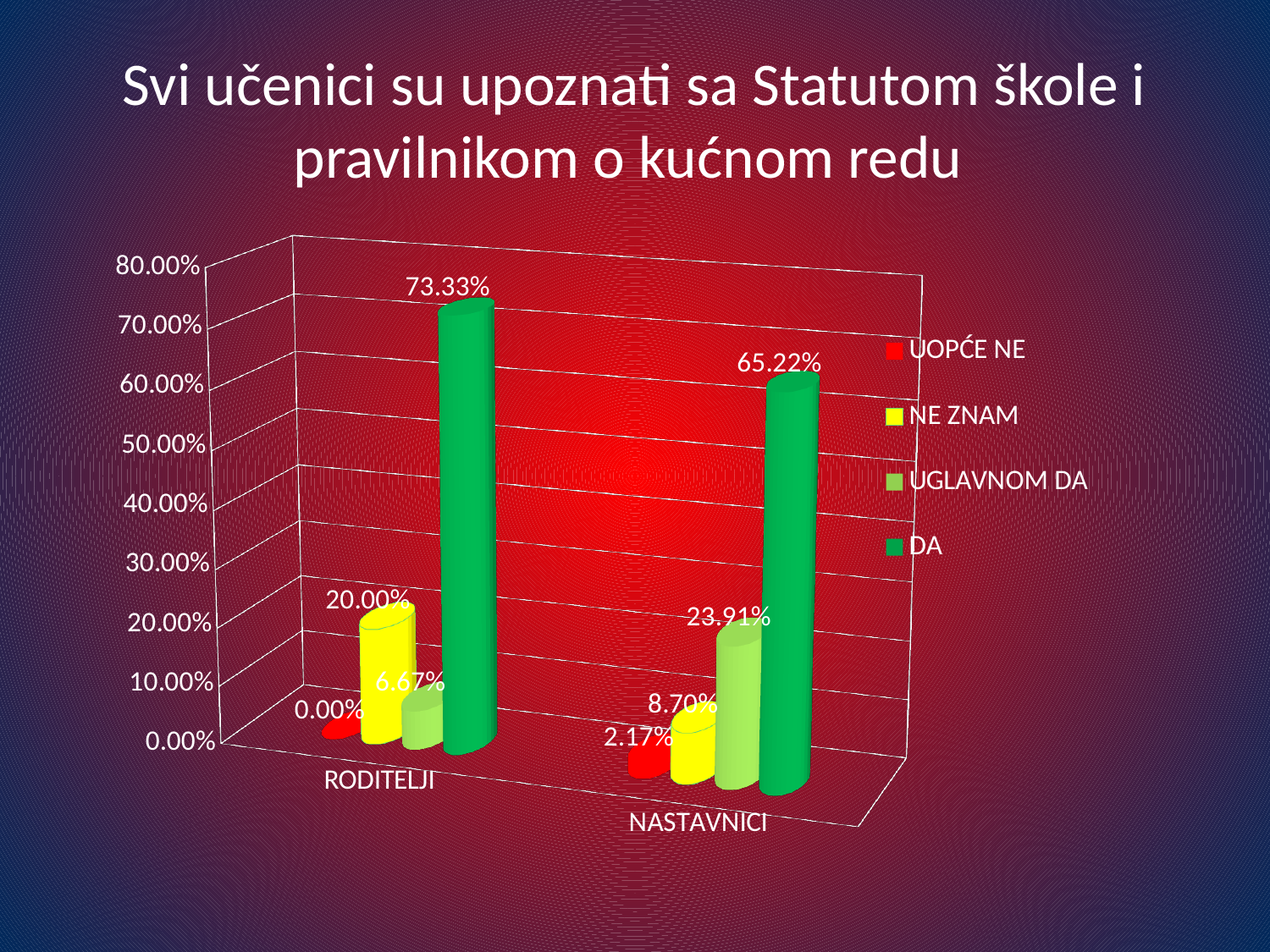
What is the value for DA in the NASTAVNICI category? 65.22% How many series does the legend list? 4 Which series has the lowest value in the NASTAVNICI category? UOPĆE NE How many categories are shown on the x axis? 2 What kind of chart is shown on the slide? Bar chart What is the value for NE ZNAM in the RODITELJI category? 20.00% Which is larger: NE ZNAM for RODITELJI or NE ZNAM for NASTAVNICI? RODITELJI What is the value for DA in the RODITELJI category? 73.33% Which series has the highest value in the RODITELJI category? DA What is the difference between the DA values for RODITELJI and NASTAVNICI? 8.11% What is the value for UOPĆE NE in the NASTAVNICI category? 2.17% What is the value for UGLAVNOM DA in the NASTAVNICI category? 23.91%